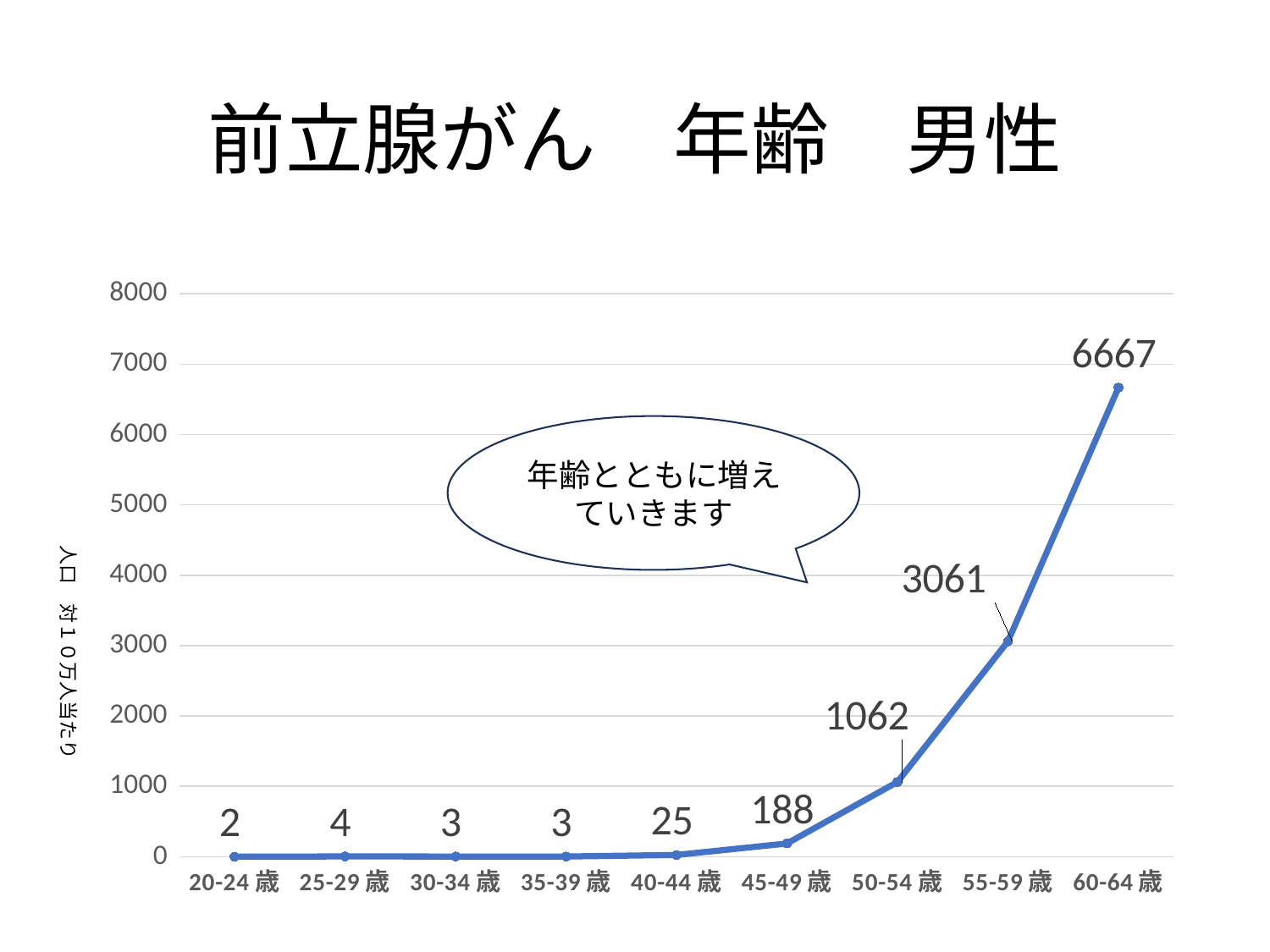
What is the value for the 45-49 歳 age group? 188 What is the difference between the values for 50-54 歳 and 45-49 歳? 874 What is the difference between the values for 60-64 歳 and 55-59 歳? 3606 Which is larger, the value for 25-29 歳 or the value for 30-34 歳? 25-29 歳 What kind of chart is shown on the slide? Line chart Do the values rise or fall as age increases along the x axis? Rise What is the value for the 40-44 歳 age group? 25 Which age group has the highest value? 60-64 歳 How many age groups are plotted on the x axis? 9 What is the value for the 60-64 歳 age group? 6667 What is the value for the 50-54 歳 age group? 1062 Which age group has the lowest value? 20-24 歳